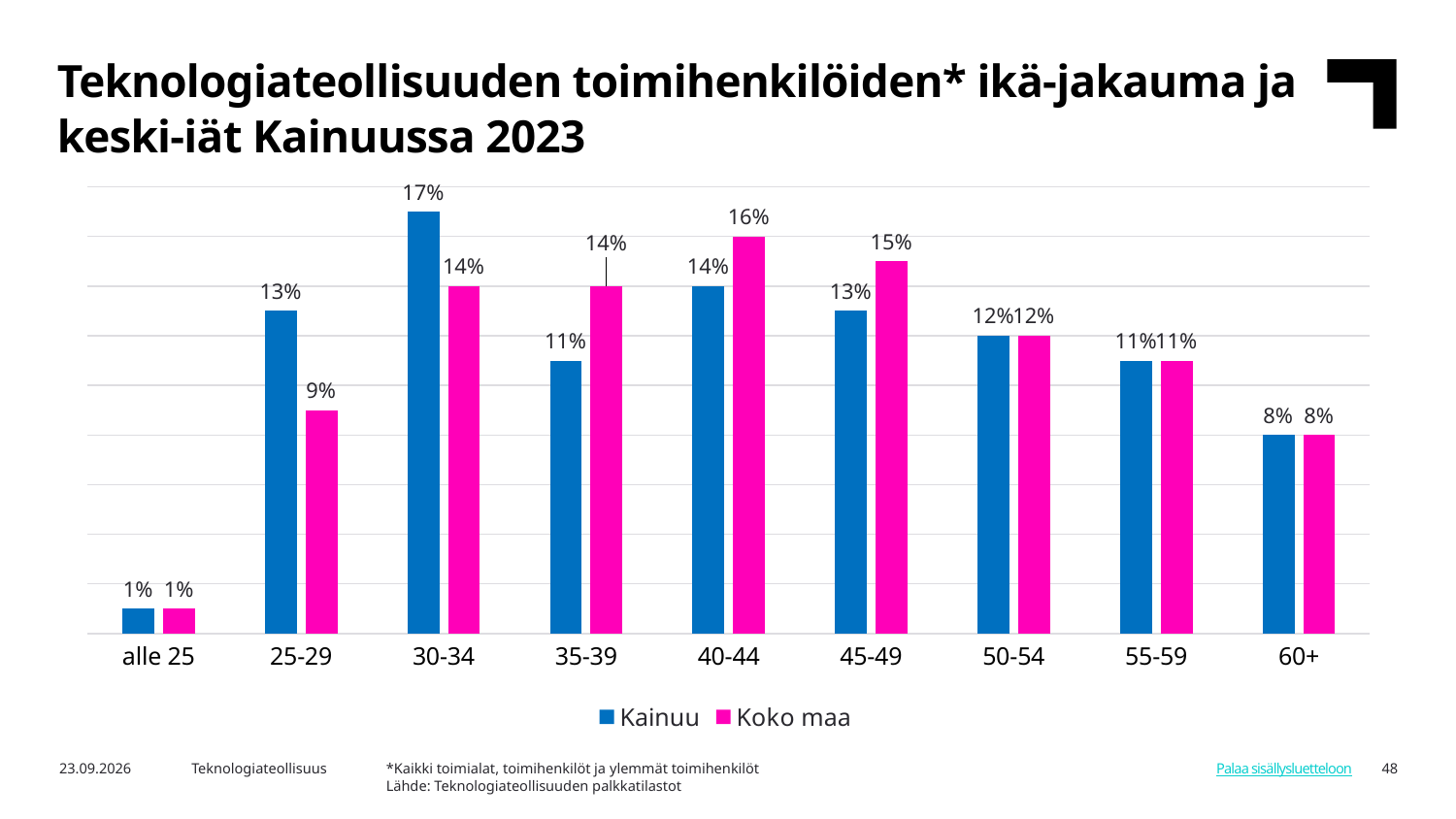
What is the value for Koko maa in the 25-29 age group? 9% Which age group has the highest value for Kainuu? 30-34 Which age group has the lowest value for Koko maa? alle 25 What is the value for Kainuu in the 30-34 age group? 17% What is the value for Kainuu in the 60+ age group? 8% What is the value for Koko maa in the 40-44 age group? 16% How many series does the legend list? 2 In the 35-39 age group, which series has the larger value, Kainuu or Koko maa? Koko maa What kind of chart is shown on the slide? Bar chart How many age groups are shown on the x axis? 9 Which colour represents the Koko maa series? Magenta (pink) What is the difference between the Kainuu and Koko maa values in the 25-29 age group? 4 percentage points